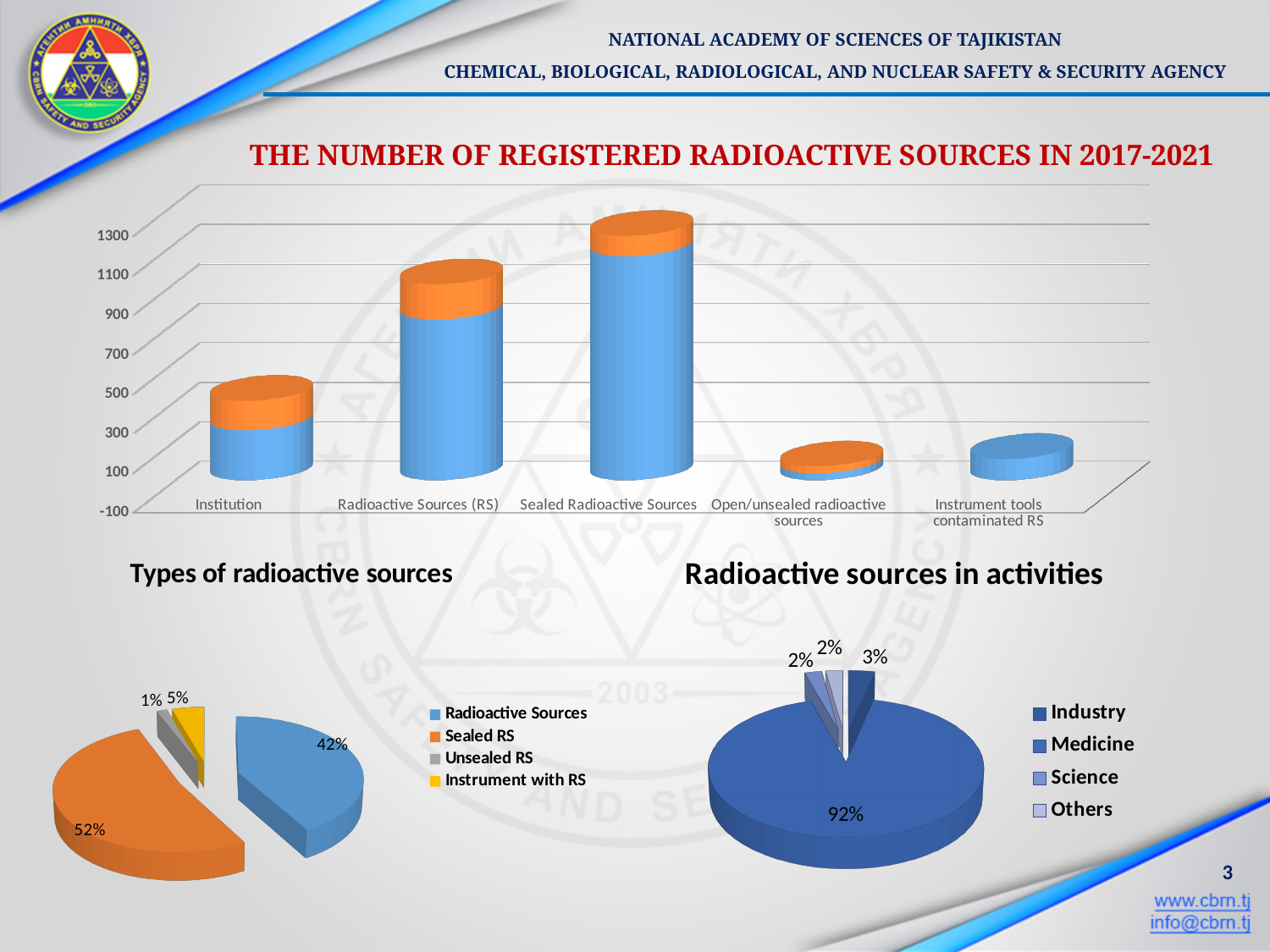
In the top bar chart, how many categories are shown on the x axis? 5 In the 'Types of radioactive sources' pie chart, what share is Radioactive Sources? 42% In the top bar chart, which category has the tallest bar? Sealed Radioactive Sources In the 'Radioactive sources in activities' pie chart, what share is Industry? 3% In the 'Types of radioactive sources' pie chart, which category has the smallest slice? Unsealed RS In the 'Types of radioactive sources' pie chart, what share is Sealed RS? 52% In the top bar chart, is the value for Sealed Radioactive Sources greater or less than 1100? greater In the top bar chart, which bar is taller: Institution or Radioactive Sources (RS)? Radioactive Sources (RS) What kind of chart is the top chart titled 'THE NUMBER OF REGISTERED RADIOACTIVE SOURCES IN 2017-2021'? bar chart In the top bar chart, is the value for Open/unsealed radioactive sources greater or less than 500? less In the 'Radioactive sources in activities' pie chart, what is the difference between the Industry share and the Medicine share? 89% In the 'Radioactive sources in activities' pie chart, how many categories does the legend list? 4